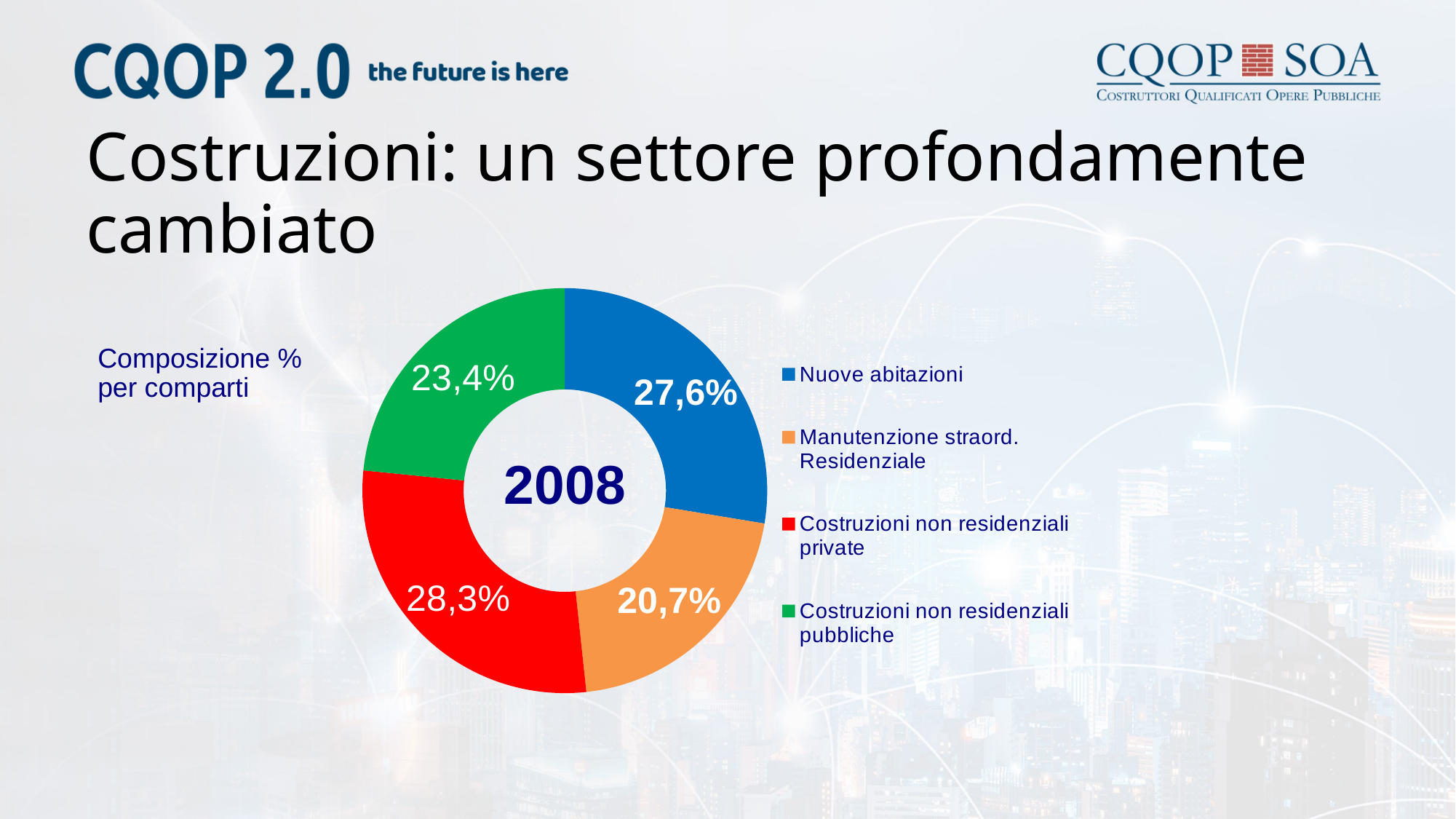
What percentage is shown for Costruzioni non residenziali private? 28,3% What is the difference in percentage points between Nuove abitazioni and Costruzioni non residenziali pubbliche? 4,2 What share of the doughnut chart is labelled for Nuove abitazioni? 27,6% Which category has the smallest share in the chart? Manutenzione straord. Residenziale What is the difference in percentage points between Costruzioni non residenziali private and Nuove abitazioni? 0,7 Which category has the largest share in the chart? Costruzioni non residenziali private How many categories does the chart show? 4 What kind of chart is shown on the slide? Doughnut (pie) chart What percentage is shown for Manutenzione straord. Residenziale? 20,7% What year is written in the centre of the doughnut chart? 2008 What percentage is shown for Costruzioni non residenziali pubbliche? 23,4% Which is larger: the share for Costruzioni non residenziali pubbliche or for Manutenzione straord. Residenziale? Costruzioni non residenziali pubbliche